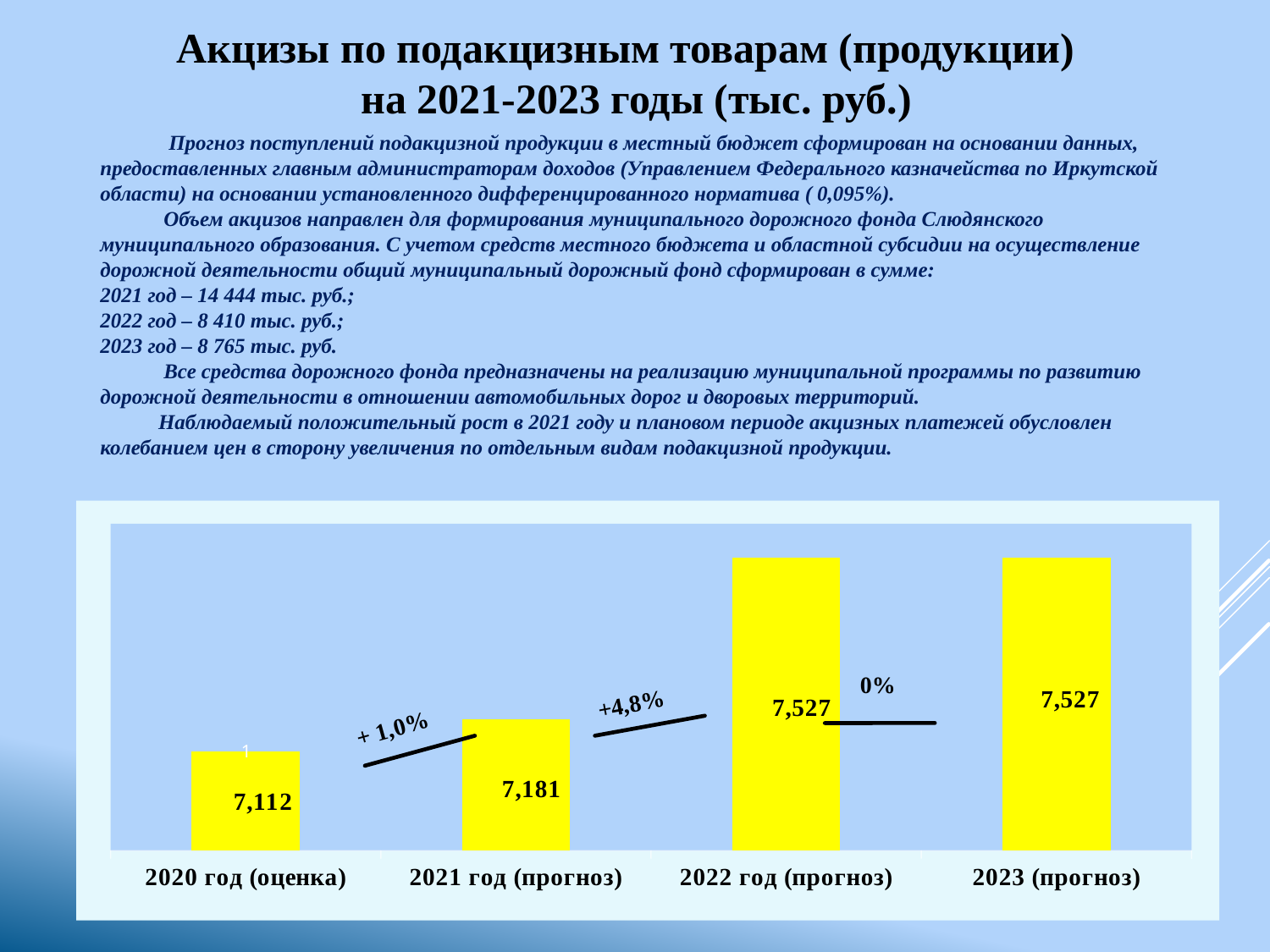
What is the value for 2020 год (оценка)? 7,112 Which category has the lowest value? 2020 год (оценка) How many categories are shown on the x axis? 4 What percentage change is annotated between 2021 год (прогноз) and 2022 год (прогноз)? +4,8% What kind of chart is shown on the slide? bar chart What is the difference between the values for 2021 год (прогноз) and 2020 год (оценка)? 69 Which is larger, the value for 2021 год (прогноз) or the value for 2022 год (прогноз)? 2022 год (прогноз) Do the values rise or fall from 2020 год (оценка) to 2022 год (прогноз)? rise What is the difference between the values for 2022 год (прогноз) and 2021 год (прогноз)? 346 What is the value for 2023 (прогноз)? 7,527 What is the value for 2021 год (прогноз)? 7,181 What is the value for 2022 год (прогноз)? 7,527